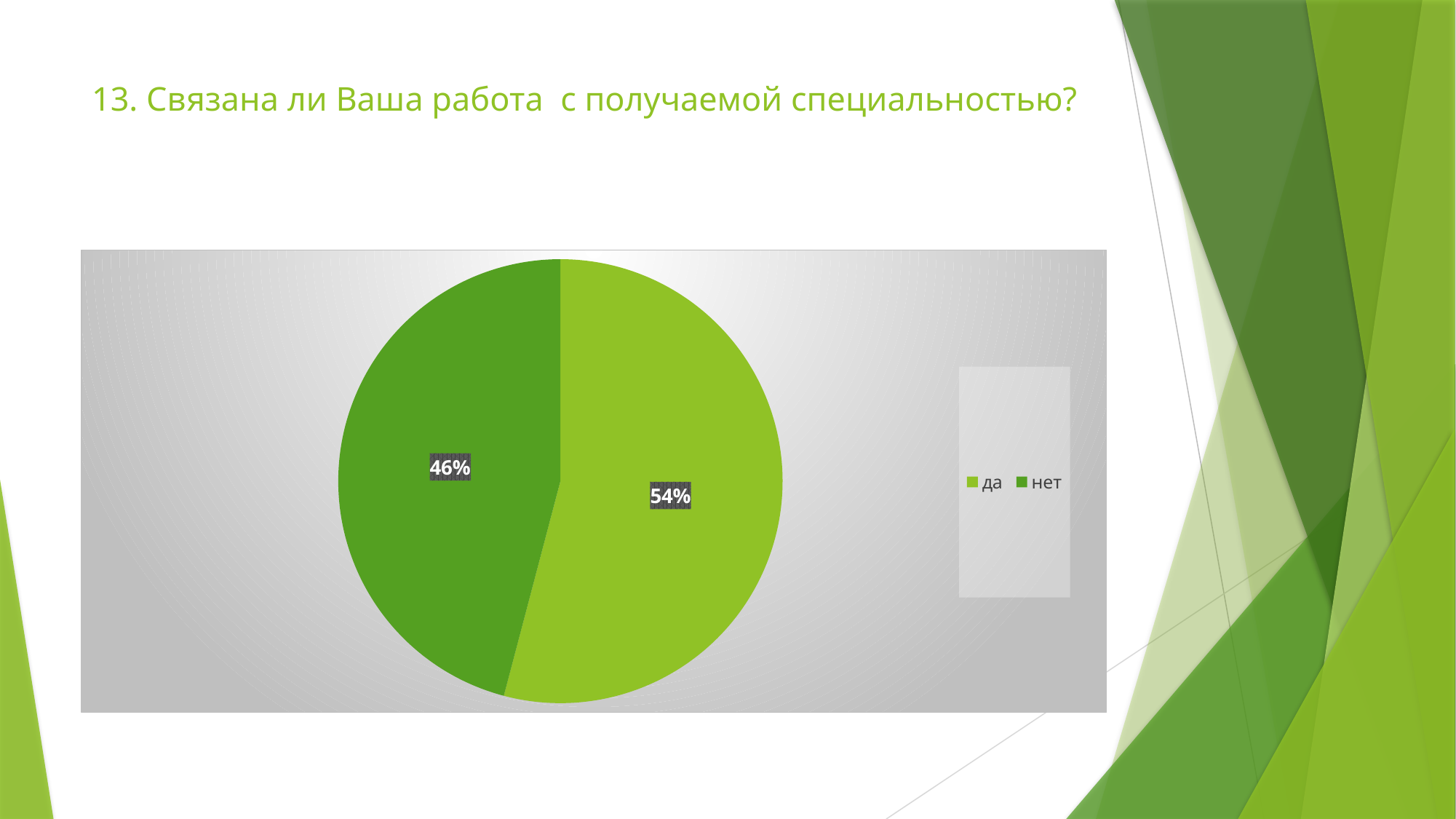
Which legend entry is shown in the darker green colour? нет What kind of chart is shown on the slide? pie chart What share of the pie is labelled "да"? 54% How many slices does the pie chart have? 2 Which slice is the smallest? нет What is the title of the slide above the chart? 13. Связана ли Ваша работа с получаемой специальностью? What is the difference in percentage points between the "да" and "нет" slices? 8 Which slice is the largest? да Which slice is larger, "да" or "нет"? да How many entries does the legend list? 2 Is the share for "нет" greater or less than 50%? less What share of the pie is labelled "нет"? 46%